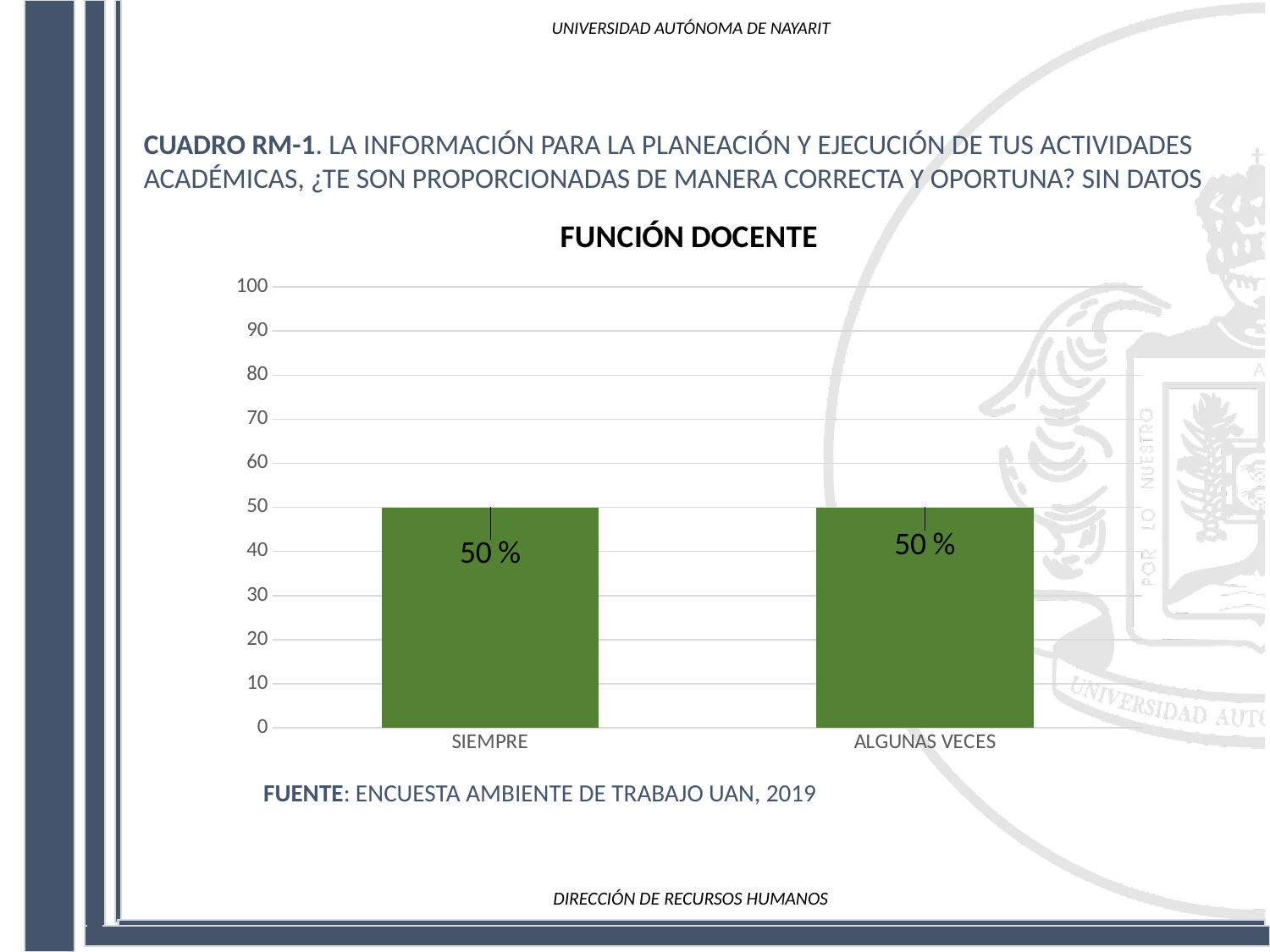
What colour are the bars in the chart? green What kind of chart is shown on the slide? bar chart What is the value for ALGUNAS VECES? 50 % How many categories are shown on the x axis? 2 Is the value for SIEMPRE greater or less than 60? less What is the title of the chart? FUNCIÓN DOCENTE What is the value for SIEMPRE? 50 % Is the value for ALGUNAS VECES greater or less than 40? greater What is the highest value shown on the y axis? 100 What is the difference between the values for SIEMPRE and ALGUNAS VECES? 0